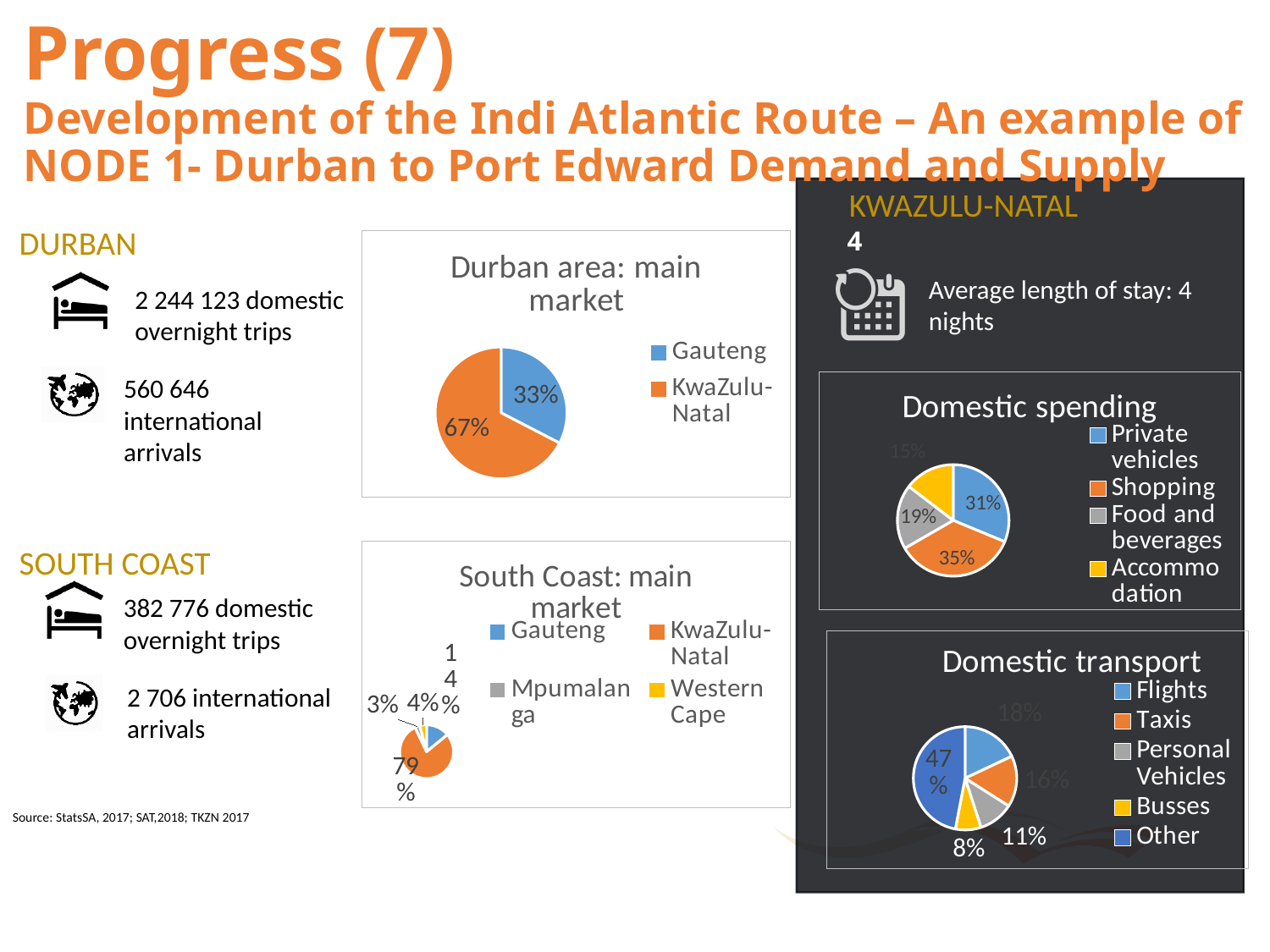
In the 'South Coast: main market' chart, what share does KwaZulu-Natal have? 79% In the 'Durban area: main market' chart, what share does Gauteng have? 33% In the 'Domestic transport' chart, what share is Busses? 8% How many categories does the legend of the 'Domestic spending' chart list? 4 In the 'Domestic spending' chart, what share is Shopping? 35% In the 'Domestic spending' chart, which category has the largest share? Shopping In the 'Durban area: main market' chart, what is the difference between the KwaZulu-Natal and Gauteng shares? 34 percentage points In the 'Durban area: main market' chart, what share does KwaZulu-Natal have? 67% In the 'Domestic transport' chart, which is larger, Personal Vehicles or Busses? Personal Vehicles In the 'Domestic transport' chart, what share is Other? 47% What type of chart is the 'Domestic spending' chart? Pie chart In the 'Domestic spending' chart, what share is Food and beverages? 19%